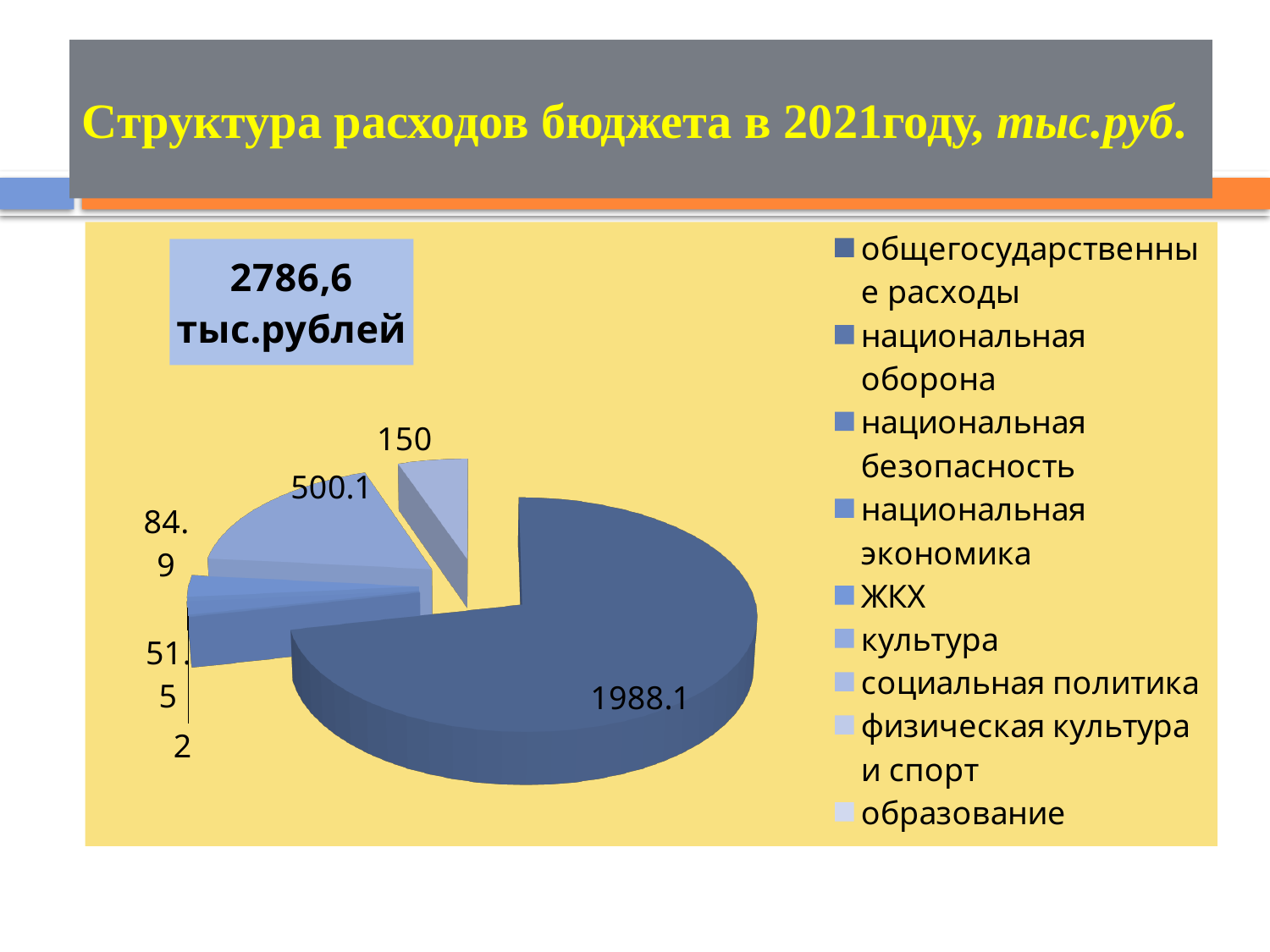
Which labelled slice is larger: the one labelled 500.1 or the one labelled 150? 500.1 Which legend category corresponds to the largest slice of the pie (1988.1)? общегосударственные расходы What kind of chart is shown on the slide? pie chart Which legend entry is listed last in the chart's legend? образование What is the difference between the slices labelled 1988.1 and 500.1? 1488 What is the title of the slide's chart? 2786,6 тыс.рублей How many categories does the chart's legend list? 9 What is the difference between the slices labelled 84.9 and 51.5? 33.4 What is the largest value labelled on the pie chart? 1988.1 What is the smallest value labelled on the pie chart? 2 What is the difference between the slices labelled 500.1 and 150? 350.1 What total amount is shown in the text box on the chart? 2786,6 тыс.рублей